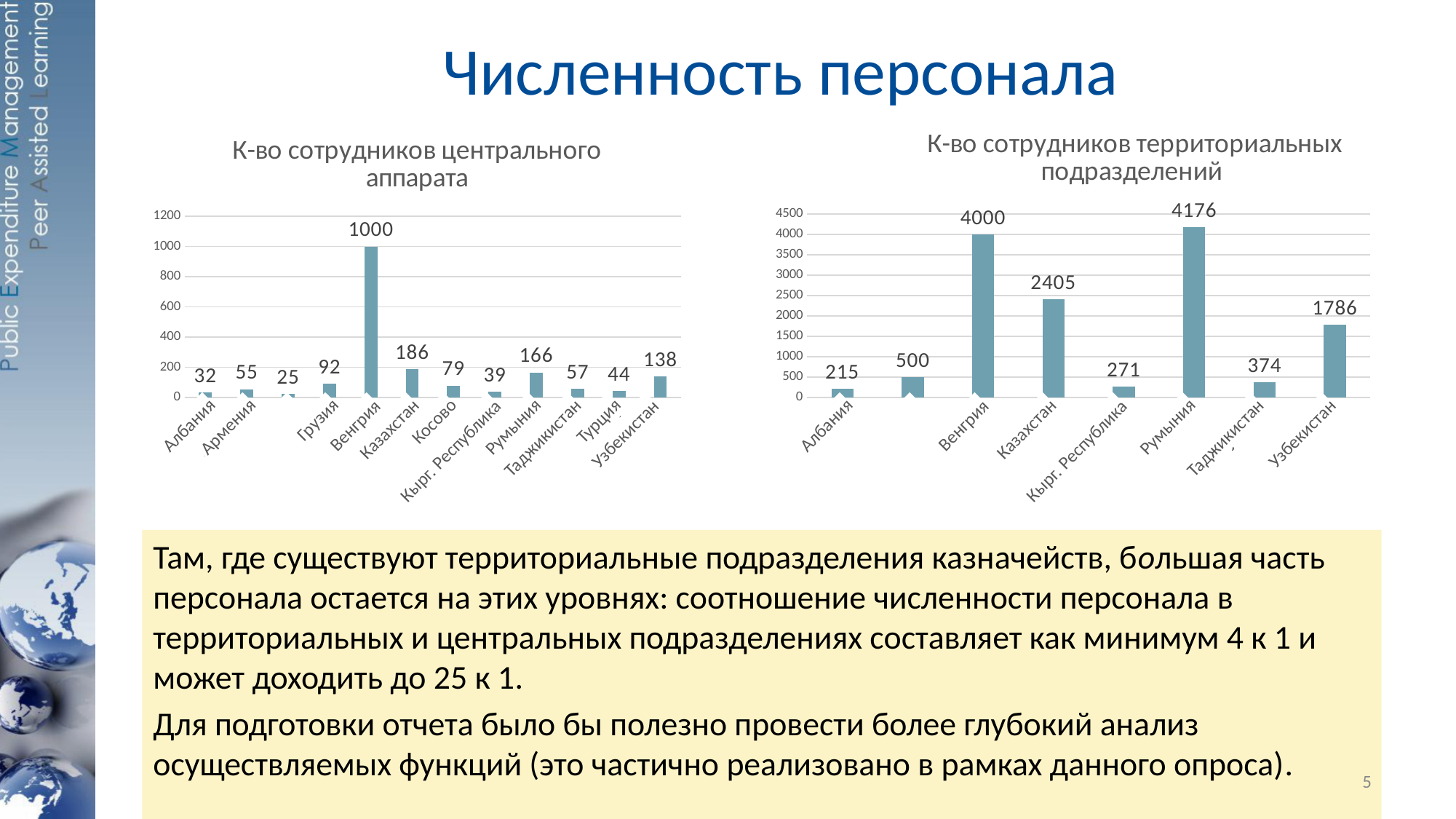
In the chart 'К-во сотрудников центрального аппарата', what is the value for Узбекистан? 138 In the chart 'К-во сотрудников территориальных подразделений', which labelled country has the lowest value? Албания In the chart 'К-во сотрудников центрального аппарата', what is the difference between the values for Румыния and Таджикистан? 109 In the chart 'К-во сотрудников территориальных подразделений', what is the value for Казахстан? 2405 In the chart 'К-во сотрудников центрального аппарата', what is the value for Казахстан? 186 In the chart 'К-во сотрудников территориальных подразделений', which labelled country has the highest value? Румыния In the chart 'К-во сотрудников территориальных подразделений', what is the value for Румыния? 4176 In the chart 'К-во сотрудников центрального аппарата', what is the value for Венгрия? 1000 In the chart 'К-во сотрудников территориальных подразделений', what is the difference between the values for Венгрия and Узбекистан? 2214 In the chart 'К-во сотрудников центрального аппарата', which is larger, the value for Косово or the value for Грузия? Грузия In the chart 'К-во сотрудников центрального аппарата', which labelled country has the highest value? Венгрия What kind of chart is 'К-во сотрудников территориальных подразделений'? Bar chart